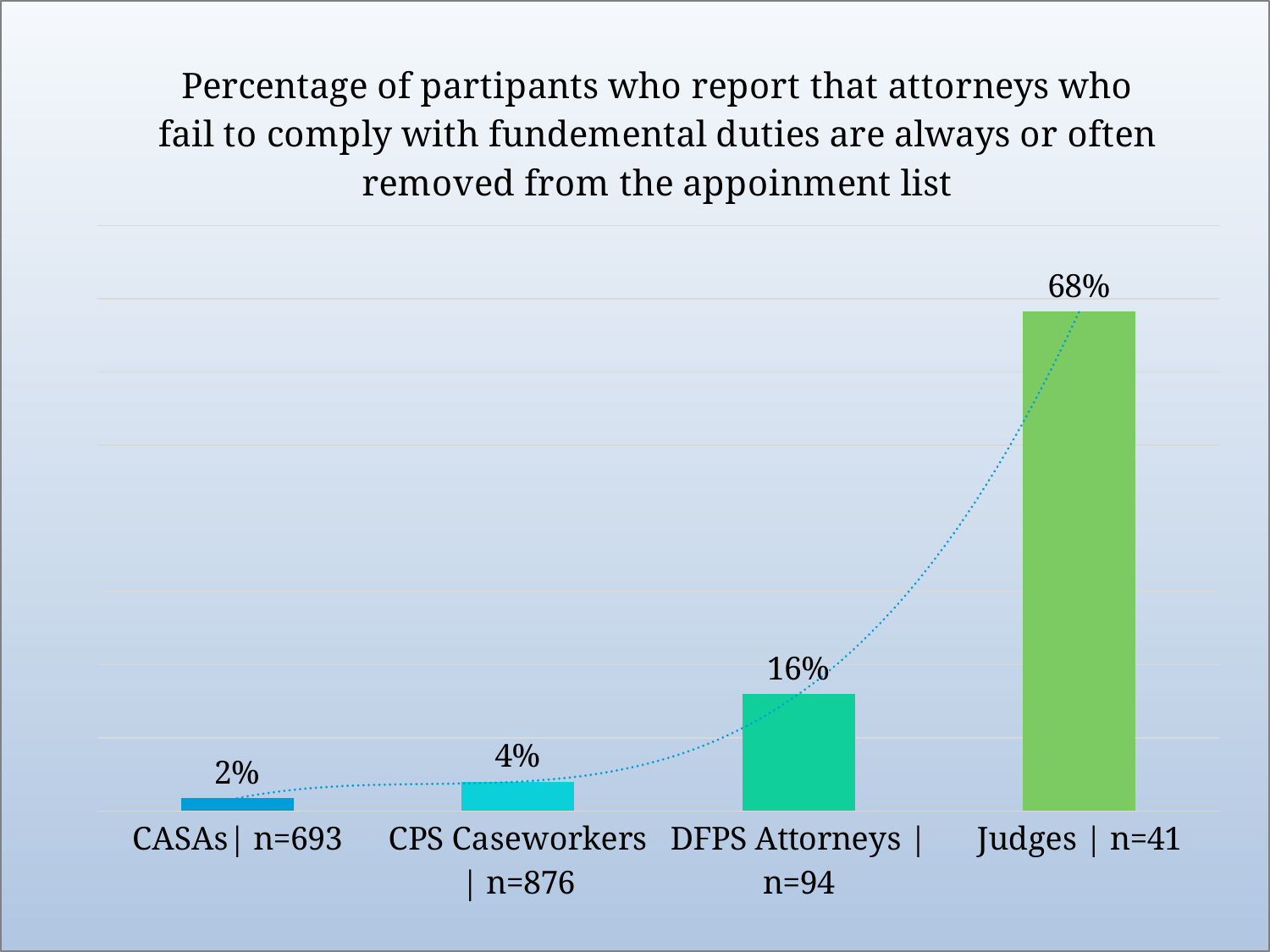
How many groups are shown on the x axis? 4 What percentage is shown for DFPS Attorneys (n=94)? 16% Which group has the highest percentage? Judges | n=41 Which is larger, the value for DFPS Attorneys or the value for CPS Caseworkers? DFPS Attorneys Which group has the lowest percentage? CASAs | n=693 What is the difference in percentage points between CPS Caseworkers and CASAs? 2 What percentage is shown for CPS Caseworkers (n=876)? 4% Do the values rise or fall moving from left to right along the x axis? Rise What kind of chart is this? Bar chart What is the difference in percentage points between Judges and DFPS Attorneys? 52 What percentage is shown for Judges (n=41)? 68% What percentage is shown for CASAs (n=693)? 2%